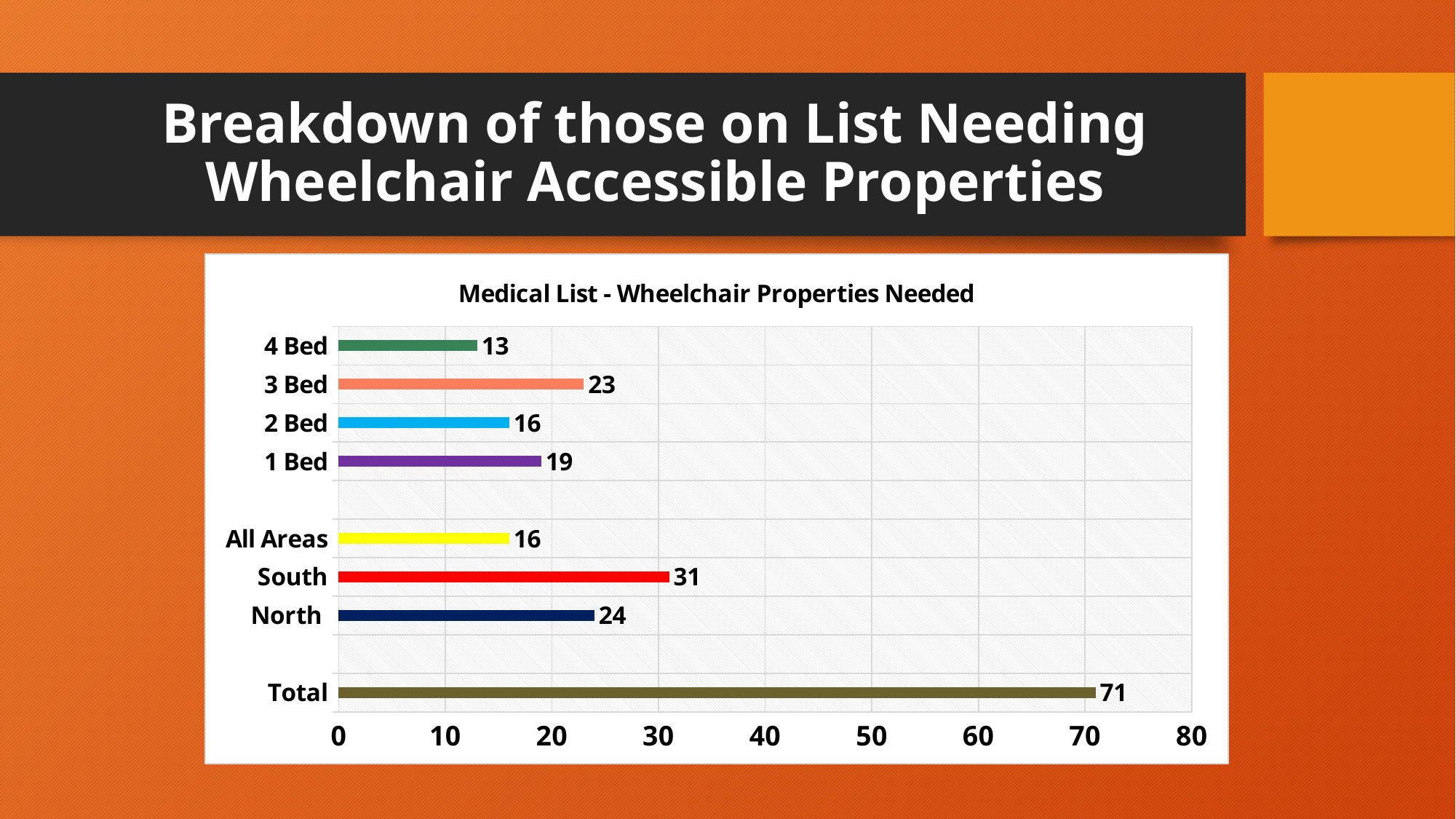
Is the value for North greater or less than 20? greater Which category has the lowest value? 4 Bed What is the difference between the values for South and North? 7 What is the value for South? 31 What kind of chart is shown on the slide? bar chart What is the difference between the values for 3 Bed and 4 Bed? 10 Which category has the highest value? Total What is the title of the chart? Medical List - Wheelchair Properties Needed Which is larger, the value for 1 Bed or the value for 2 Bed? 1 Bed How many labelled categories are plotted on the chart? 8 What is the value for Total? 71 What is the value for 3 Bed? 23